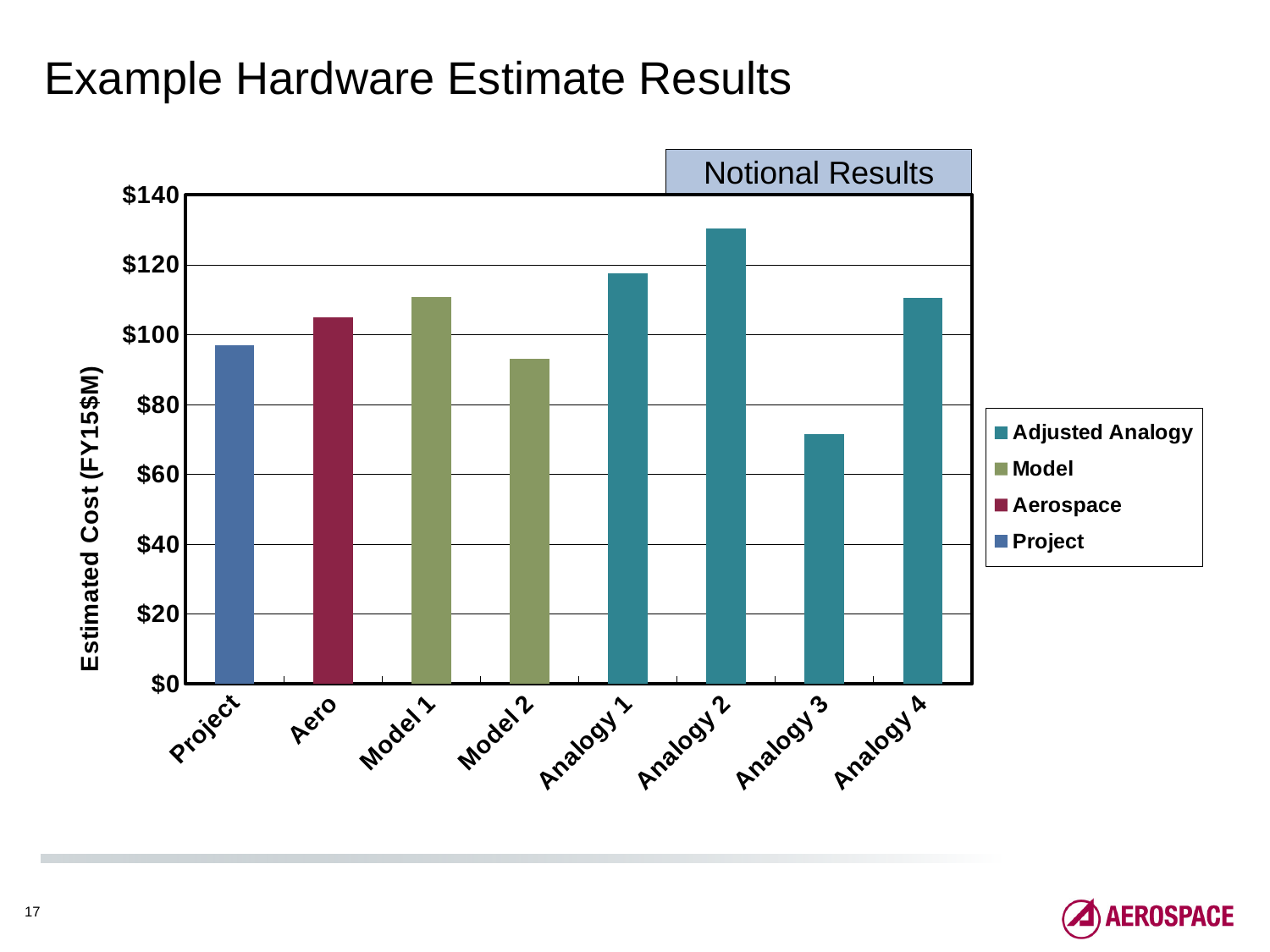
How many bars are plotted in the chart? 8 Which legend series do the Analogy 1 through Analogy 4 bars belong to? Adjusted Analogy Is the value for Analogy 2 greater or less than $120? greater What is the label on the vertical axis? Estimated Cost (FY15$M) Is the value for Analogy 3 greater or less than $80? less Is the value for Model 2 greater or less than $80? greater Which is larger, the value for Analogy 1 or the value for Aero? Analogy 1 Which category has the lowest estimated cost? Analogy 3 How many series does the legend list? 4 Which category has the highest estimated cost? Analogy 2 What kind of chart is shown on the slide? bar chart